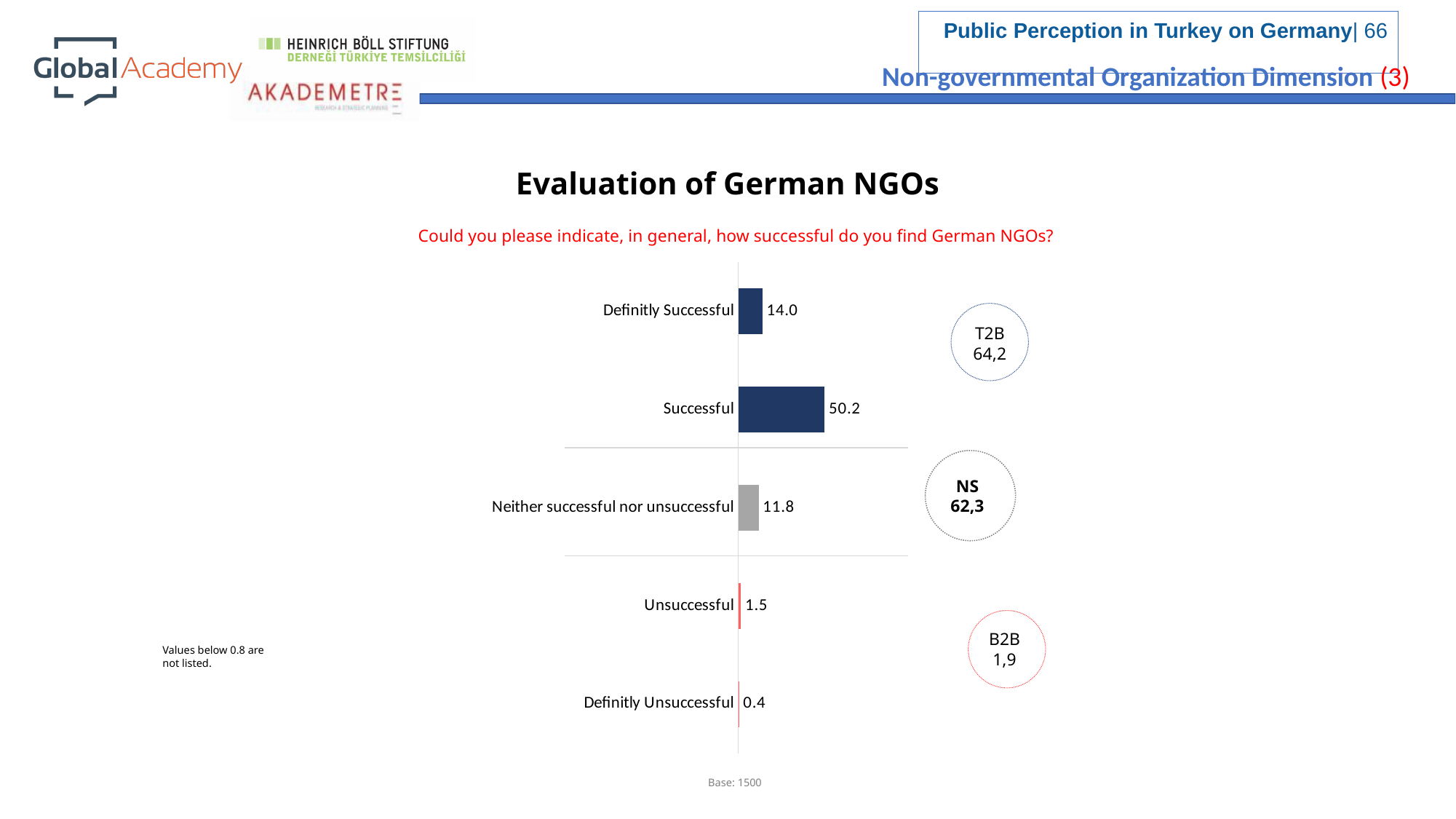
What is the difference between the values for "Successful" and "Definitly Successful"? 36.2 What is the value for "Successful" in the Evaluation of German NGOs chart? 50.2 What is the value for "Definitly Successful"? 14.0 How many categories are shown in the chart? 5 What is the value for "Definitly Unsuccessful"? 0.4 Which category has the lowest value? Definitly Unsuccessful What is the T2B value shown next to the chart? 64,2 What is the value for "Unsuccessful"? 1.5 What kind of chart is shown on the slide? Bar chart What is the value for "Neither successful nor unsuccessful"? 11.8 Which category has the highest value? Successful Which is larger, the value for "Definitly Successful" or for "Neither successful nor unsuccessful"? Definitly Successful